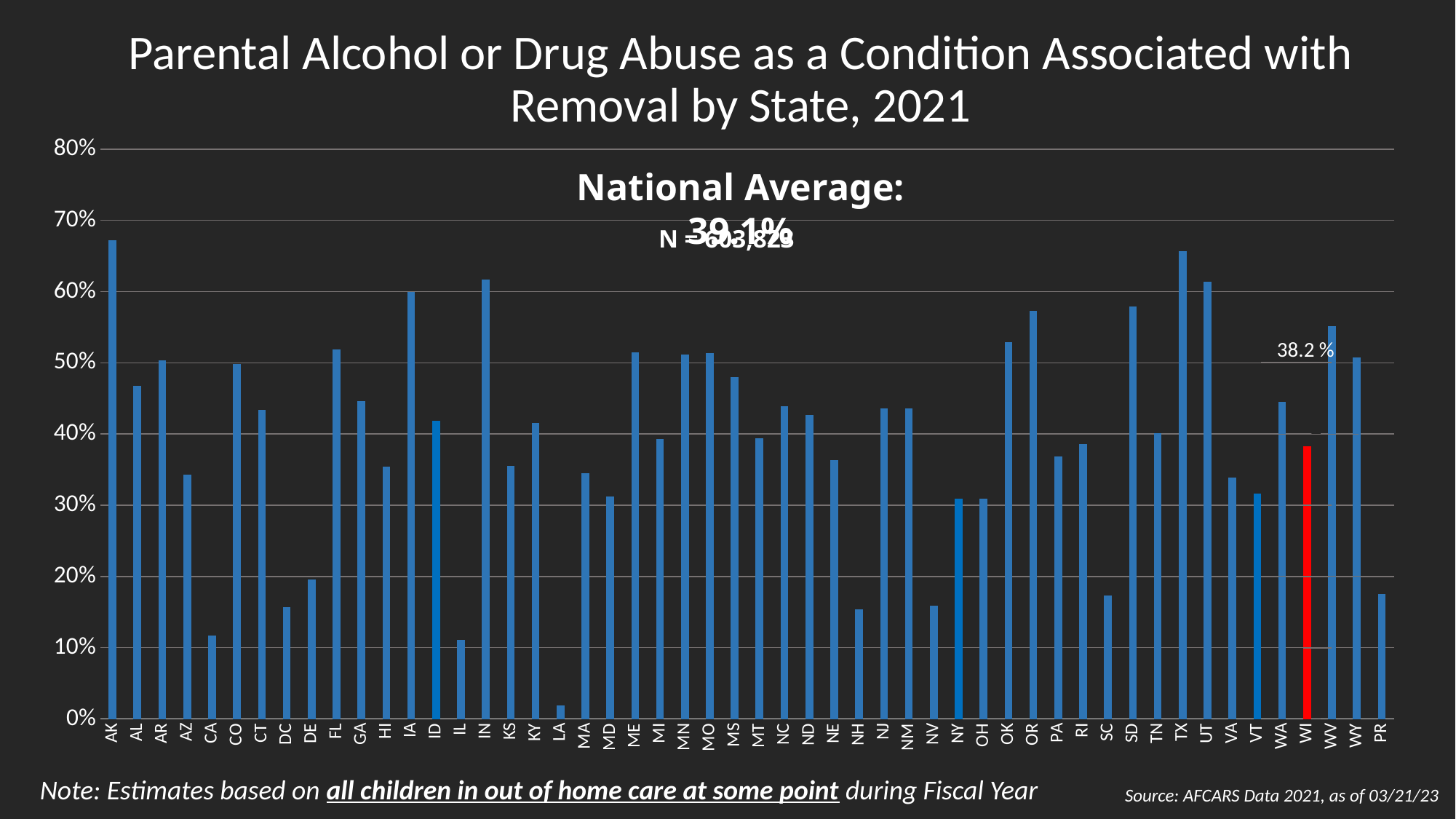
Is the value for CA greater or less than 20%? less Is the value for OR greater or less than 50%? greater What type of chart is shown on the slide? bar chart Which has a larger value, IL or IN? IN Which state has the lowest value in the chart? LA What national average is stated on the chart? 39.1% Is the value for IA greater or less than 50%? greater Which state's bar is highlighted in red? WI What value is labelled on the bar for WI? 38.2 % How many states/territories are shown on the x axis? 52 Which has a larger value, AK or CA? AK